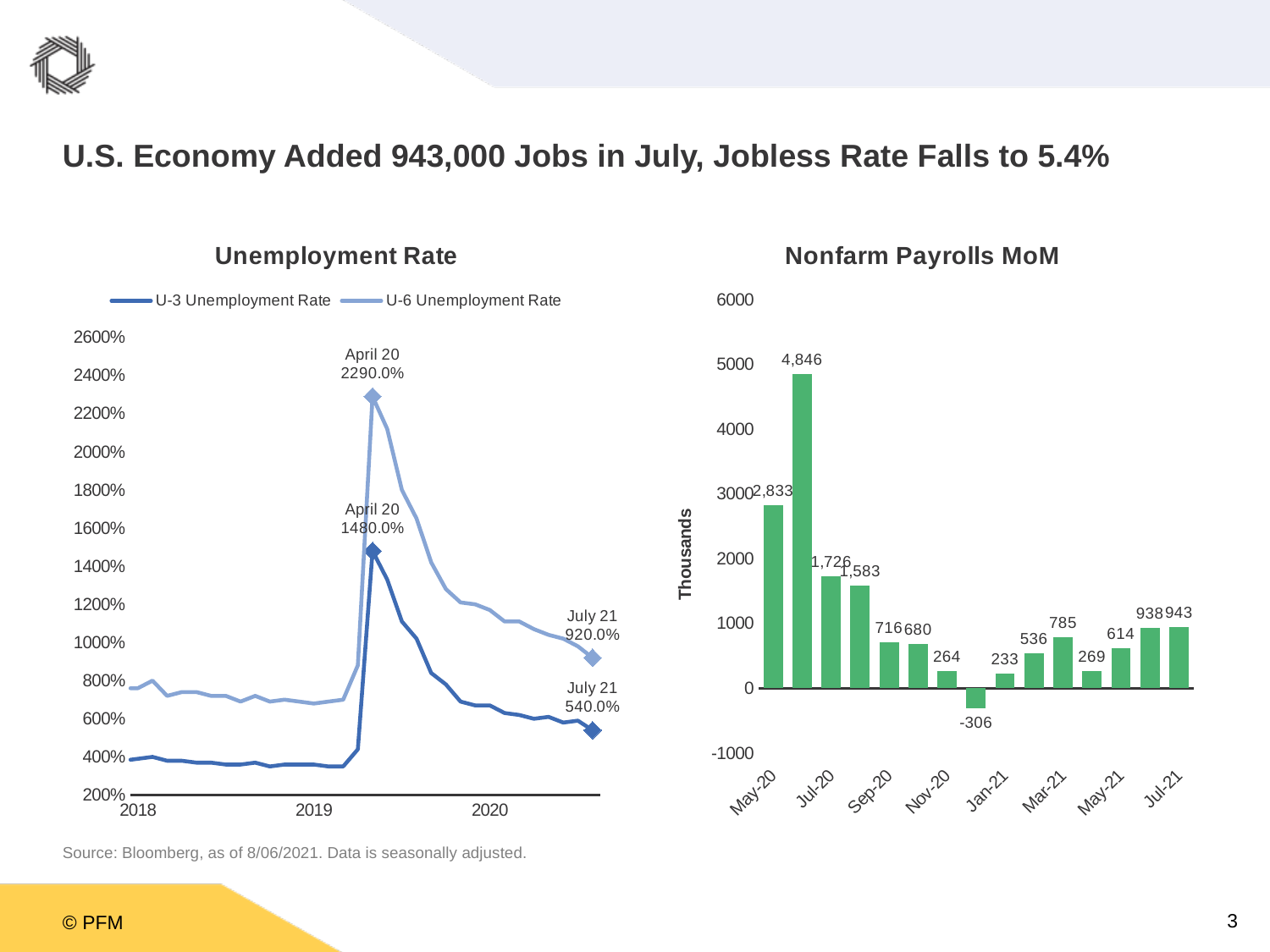
In the Nonfarm Payrolls MoM chart, what is the value for May-20? 2,833 In the Nonfarm Payrolls MoM chart, what is the lowest value shown? -306 In the Nonfarm Payrolls MoM chart, what is the value for Jul-21? 943 In the Nonfarm Payrolls MoM chart, what is the difference between the values for Jul-21 and Jan-21? 710 What kind of chart is the Nonfarm Payrolls MoM chart? bar chart How many bars are plotted in the Nonfarm Payrolls MoM chart? 15 How many series does the legend of the Unemployment Rate chart list? 2 In the Nonfarm Payrolls MoM chart, what is the highest value shown? 4,846 In the Unemployment Rate chart, what is the labeled U-6 Unemployment Rate value for April 20? 2290.0% In the Nonfarm Payrolls MoM chart, which is larger, the value for Mar-21 or the value for May-21? Mar-21 In the Unemployment Rate chart, what is the difference between the labeled U-6 and U-3 values for July 21? 380.0% In the Unemployment Rate chart, what is the labeled U-3 Unemployment Rate value for July 21? 540.0%